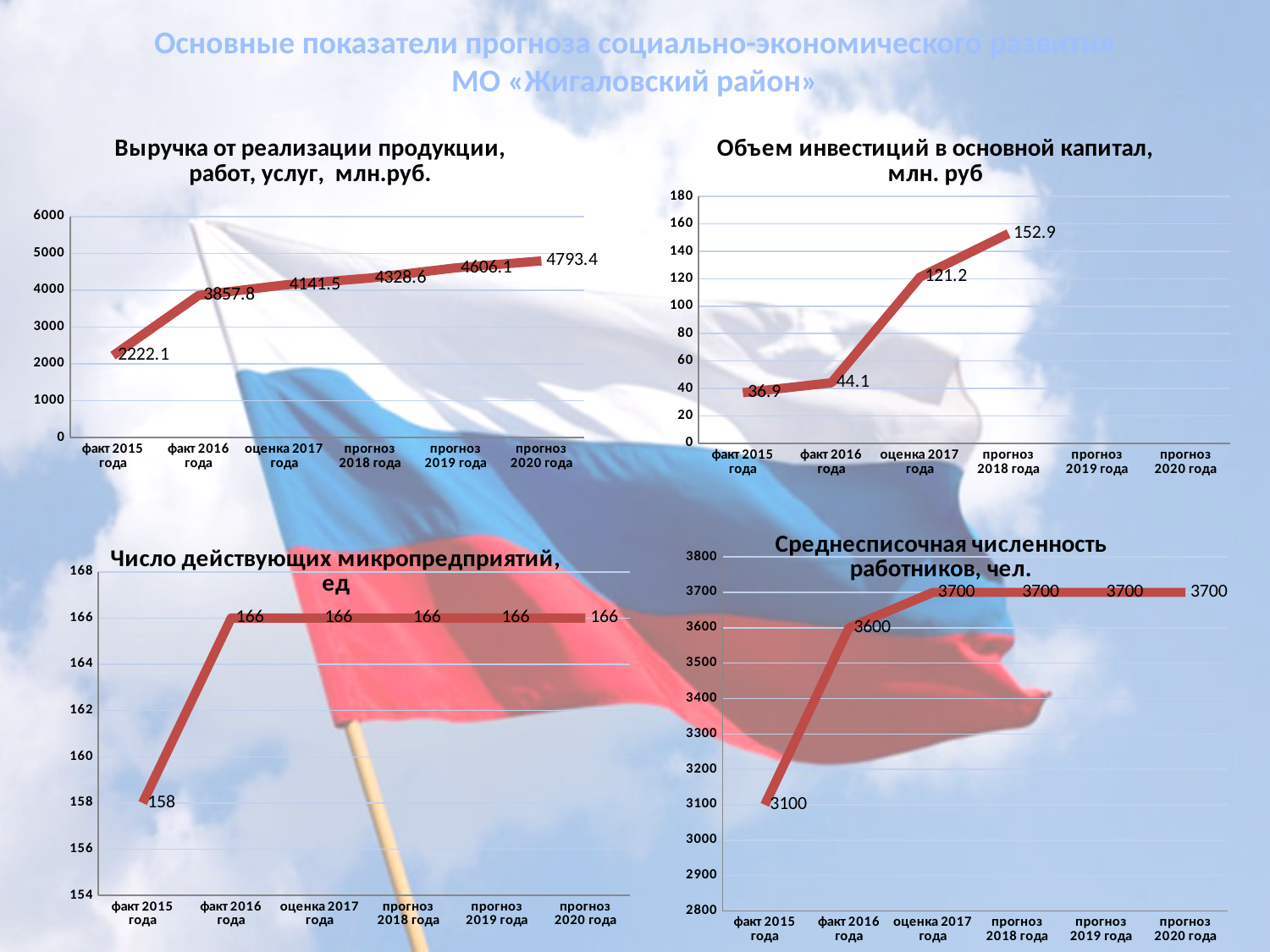
On the chart 'Среднесписочная численность работников, чел.', what is the difference between the values for 'факт 2016 года' and 'факт 2015 года'? 500 On the chart 'Выручка от реализации продукции, работ, услуг, млн.руб.', do the values rise or fall from 'факт 2015 года' to 'прогноз 2020 года'? rise On the chart 'Объем инвестиций в основной капитал, млн. руб', which category has the lowest value? факт 2015 года On the chart 'Выручка от реализации продукции, работ, услуг, млн.руб.', what is the difference between the values for 'факт 2016 года' and 'факт 2015 года'? 1635.7 On the chart 'Число действующих микропредприятий, ед', what is the value for 'факт 2015 года'? 158 What type of chart is 'Среднесписочная численность работников, чел.'? line chart On the chart 'Число действующих микропредприятий, ед', what is the value for 'прогноз 2019 года'? 166 On the chart 'Объем инвестиций в основной капитал, млн. руб', what is the value for 'оценка 2017 года'? 121.2 On the chart 'Выручка от реализации продукции, работ, услуг, млн.руб.', what is the value for 'факт 2015 года'? 2222.1 On the chart 'Выручка от реализации продукции, работ, услуг, млн.руб.', what is the value for 'прогноз 2020 года'? 4793.4 On the chart 'Объем инвестиций в основной капитал, млн. руб', which category has the highest value? прогноз 2018 года On the chart 'Объем инвестиций в основной капитал, млн. руб', how many data points are plotted? 4